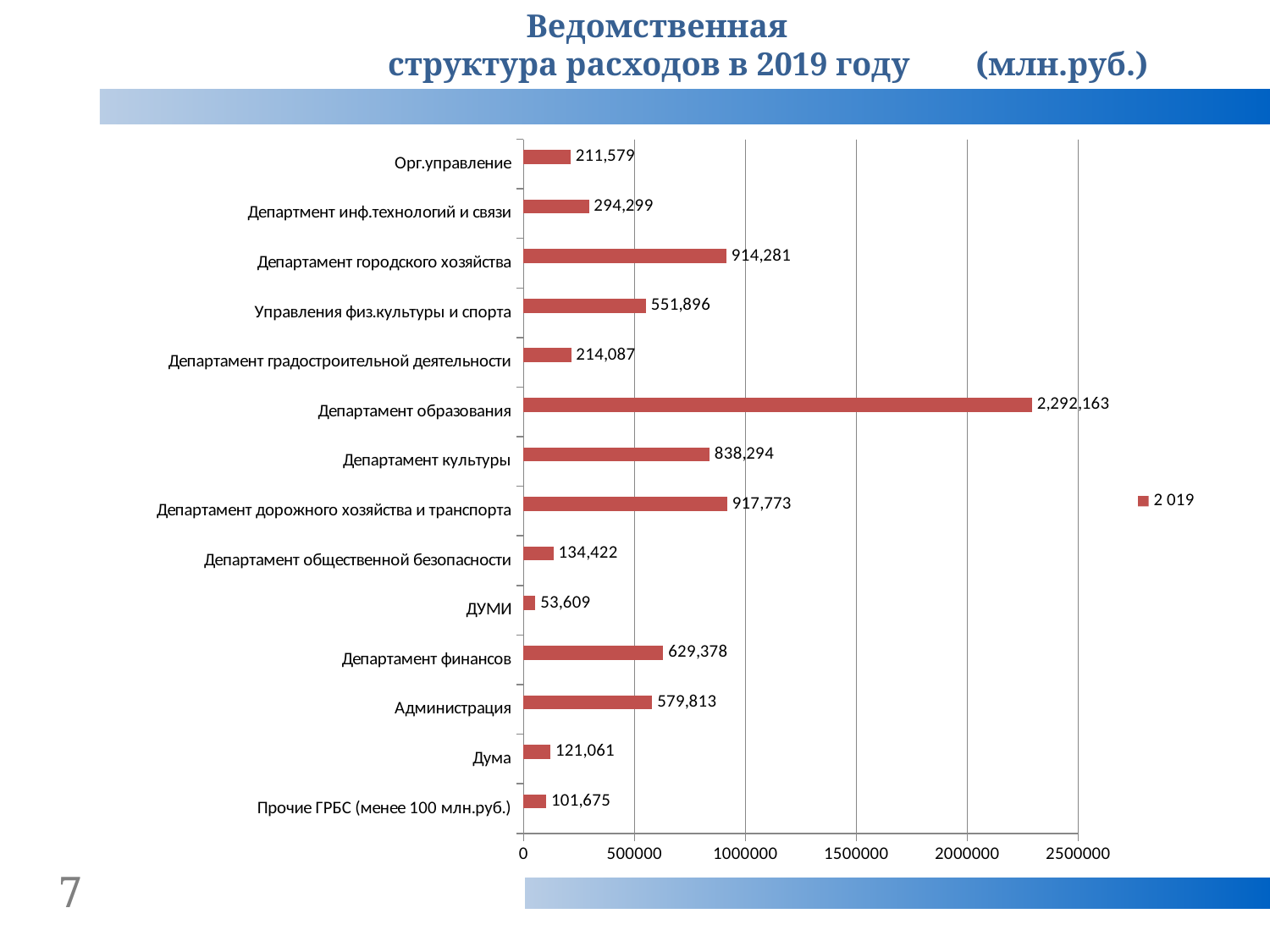
Is the value for Департамент городского хозяйства greater or less than 500000? greater Which category has the lowest value? ДУМИ Which is larger, the value for Департамент культуры or the value for Управления физ.культуры и спорта? Департамент культуры Which category has the highest value? Департамент образования What is the value for ДУМИ? 53,609 What is the value for Департамент финансов? 629,378 How many categories are shown in the chart? 14 What is the value for Департамент образования? 2,292,163 What is the difference between the values for Департамент финансов and Администрация? 49,565 What kind of chart is shown on the slide? bar chart What is the value for Прочие ГРБС (менее 100 млн.руб.)? 101,675 How many series does the legend list? 1